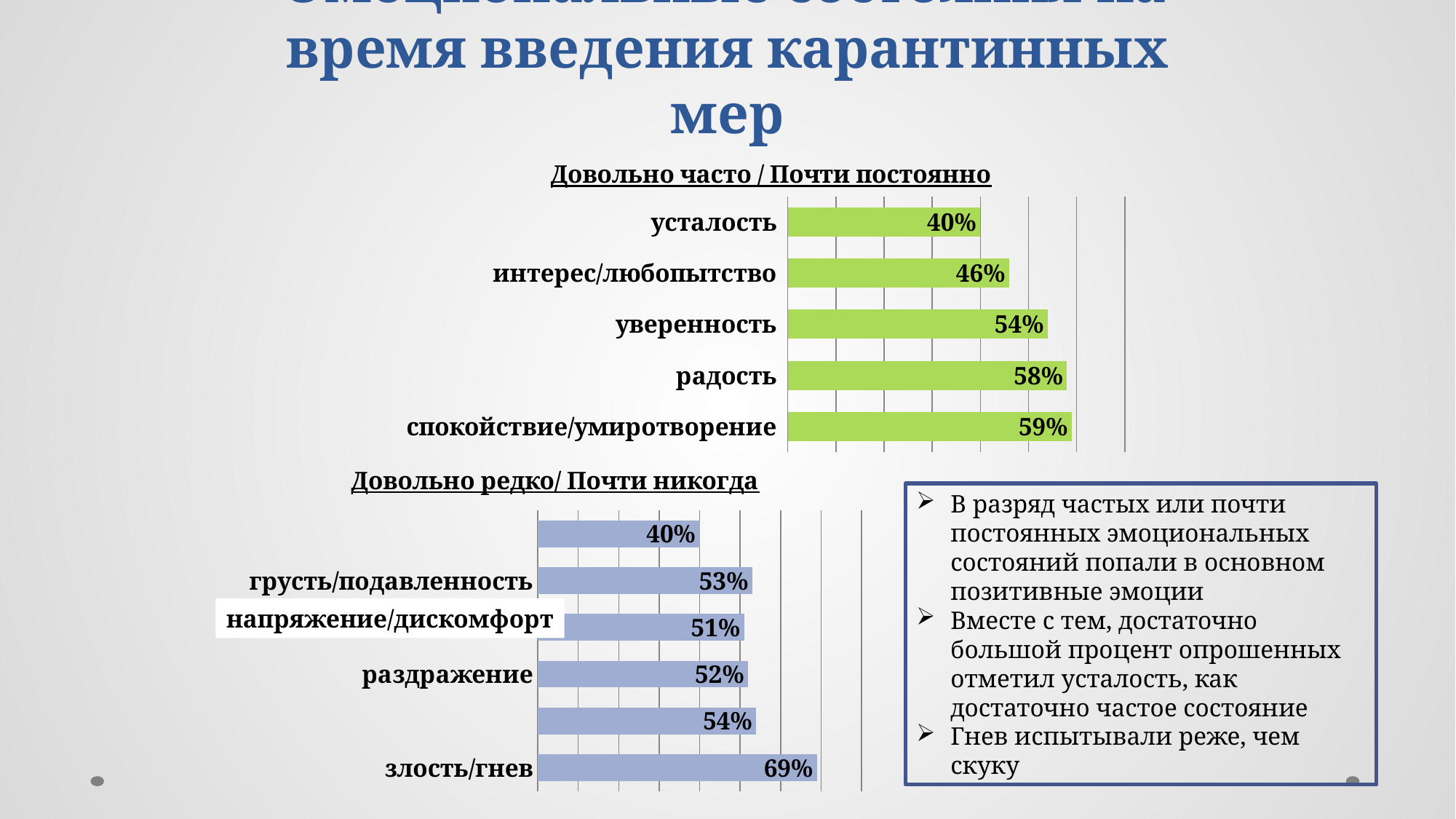
In the chart titled "Довольно часто / Почти постоянно", what is the value for усталость? 40% In the chart titled "Довольно часто / Почти постоянно", how many categories are shown? 5 In the chart titled "Довольно редко/ Почти никогда", what is the value for злость/гнев? 69% In the chart titled "Довольно редко/ Почти никогда", which category has the highest value? злость/гнев In the chart titled "Довольно редко/ Почти никогда", what is the value for напряжение/дискомфорт? 51% In the chart titled "Довольно редко/ Почти никогда", which is larger: грусть/подавленность or раздражение? грусть/подавленность In the chart titled "Довольно часто / Почти постоянно", which category has the lowest value? усталость In the chart titled "Довольно редко/ Почти никогда", how many bars are shown? 6 What type of chart is the chart titled "Довольно часто / Почти постоянно"? bar chart In the chart titled "Довольно часто / Почти постоянно", what is the difference between уверенность and интерес/любопытство? 8% In the chart titled "Довольно часто / Почти постоянно", which category has the highest value? спокойствие/умиротворение In the chart titled "Довольно часто / Почти постоянно", what is the value for радость? 58%